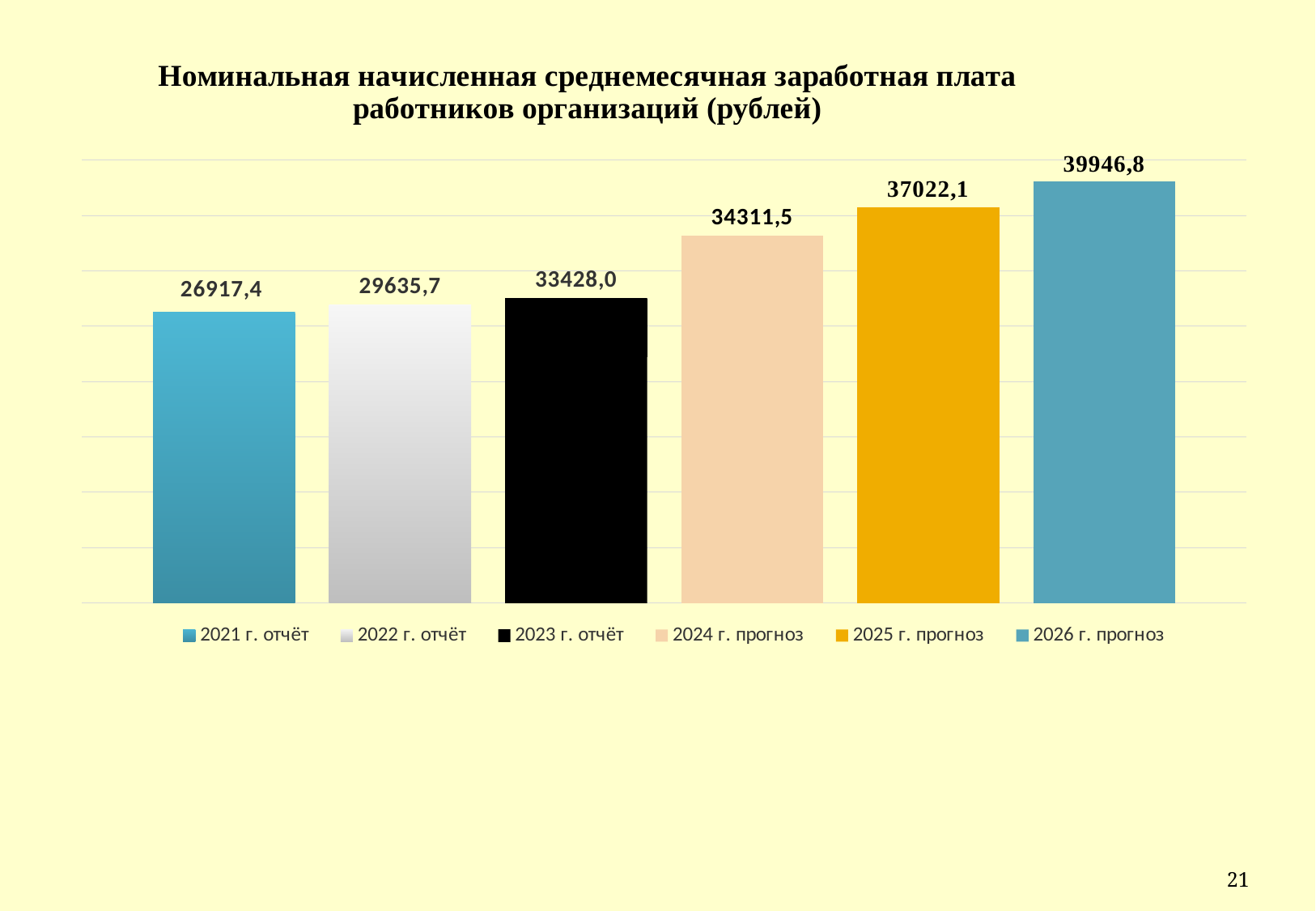
What is the value shown for 2026 г. прогноз? 39946,8 What kind of chart is shown on the slide? Bar chart Which is larger, the value for 2023 г. отчёт or the value for 2022 г. отчёт? 2023 г. отчёт How many entries does the legend list? 6 Which year has the lowest value on the chart? 2021 г. отчёт What is the value shown for 2024 г. прогноз? 34311,5 Which year has the highest value on the chart? 2026 г. прогноз What is the difference between the values for 2026 г. прогноз and 2021 г. отчёт? 13029,4 Do the values rise or fall from 2021 to 2026? Rise What is the value shown for 2021 г. отчёт? 26917,4 How many bars are shown on the chart? 6 What is the difference between the values for 2025 г. прогноз and 2024 г. прогноз? 2710,6